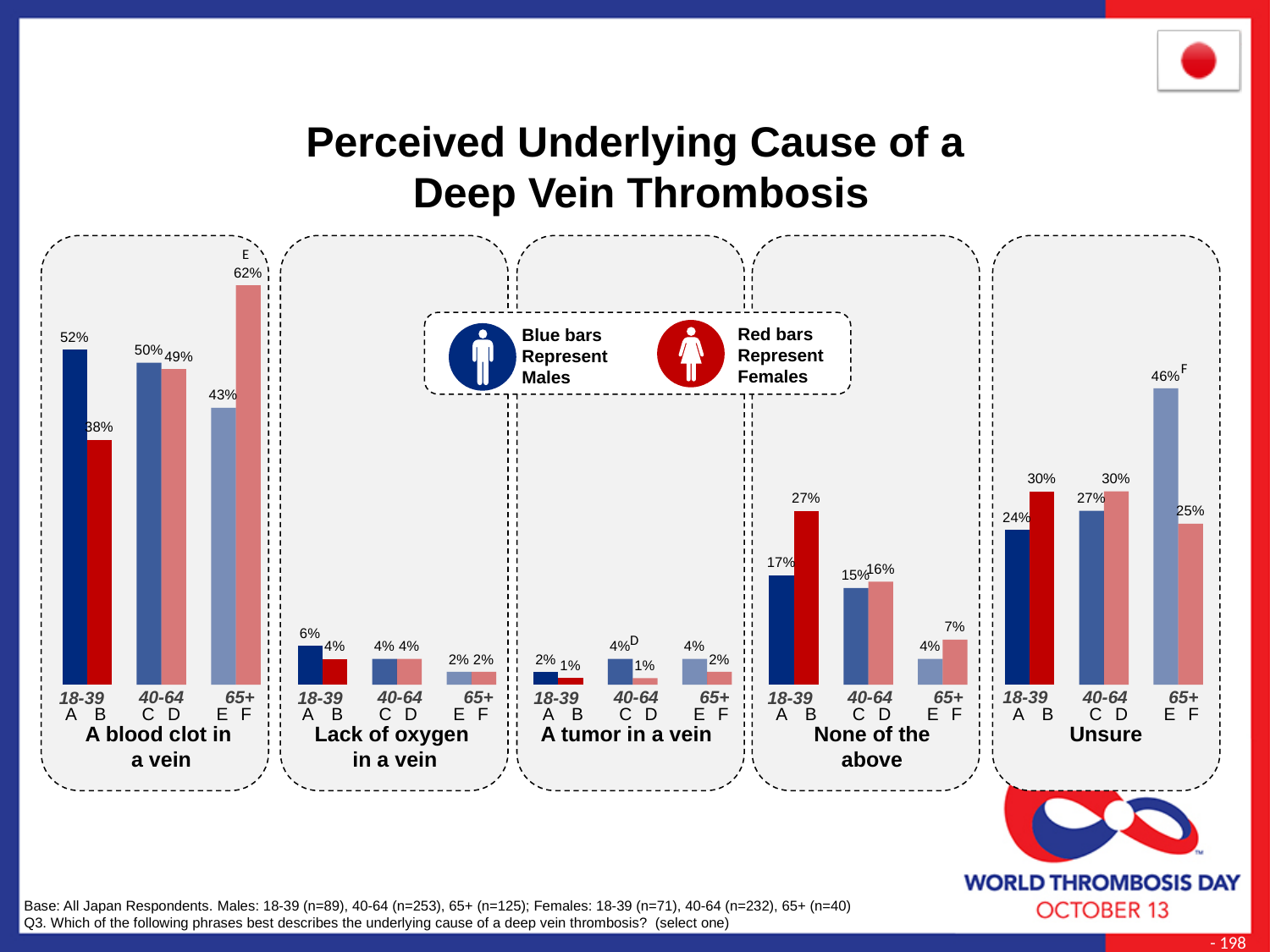
According to the legend, what do the red bars represent? Females In the 'A blood clot in a vein' chart, what is the difference between females aged 65+ and males aged 65+? 19% In the 'A blood clot in a vein' chart, what is the value for females aged 65+? 62% In the 'Unsure' chart, what is the value for males aged 65+? 46% In the 'Lack of oxygen in a vein' chart, which is larger: males aged 18-39 or females aged 18-39? Males aged 18-39 What type of chart is used on this slide? Bar chart In the 'A blood clot in a vein' chart, which bar is the highest? Females 65+ (62%) How many age groups are shown in each chart? 3 In the 'None of the above' chart, which bar is the lowest? Males 65+ (4%) In the 'A blood clot in a vein' chart, what is the value for males aged 18-39? 52% In the 'Unsure' chart, what is the difference between males aged 65+ and females aged 65+? 21% In the 'None of the above' chart, what is the value for females aged 18-39? 27%